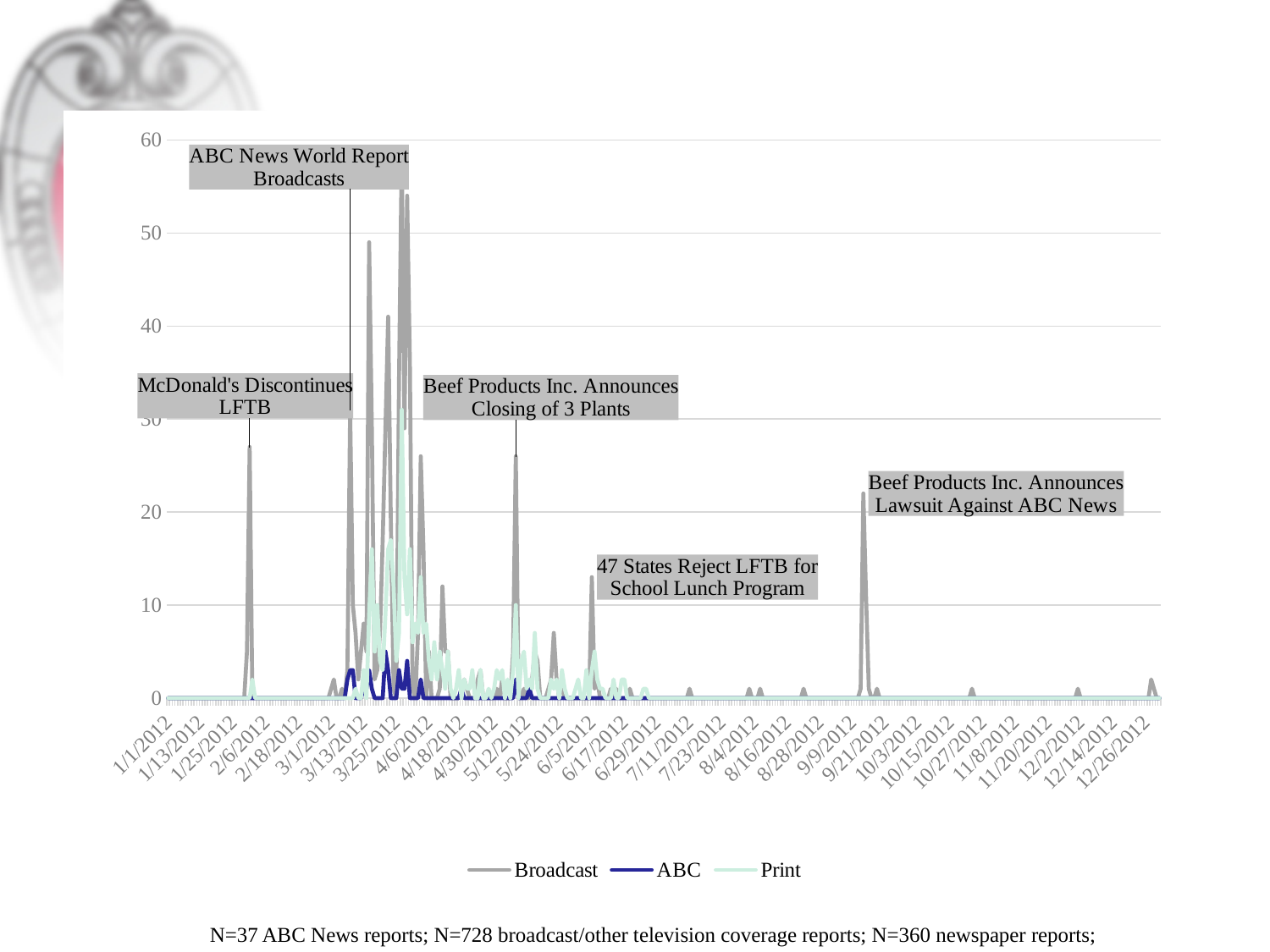
Which series has a higher peak, Broadcast or ABC? Broadcast How many series does the legend list? 3 Is the highest value of the ABC series greater or less than 10? less Is the highest peak of the Broadcast series greater or less than 50? greater Which series reaches the highest value on the chart? Broadcast Is the Broadcast peak at the 'McDonald's Discontinues LFTB' annotation greater or less than 30? less Which event annotation is placed near the Broadcast spike in late September 2012? Beef Products Inc. Announces Lawsuit Against ABC News What are the three series named in the legend? Broadcast, ABC, Print Which series has the lowest peak value on the chart? ABC Do the Broadcast values generally rise or fall from April 2012 to August 2012? fall What kind of chart is shown on the slide? line chart